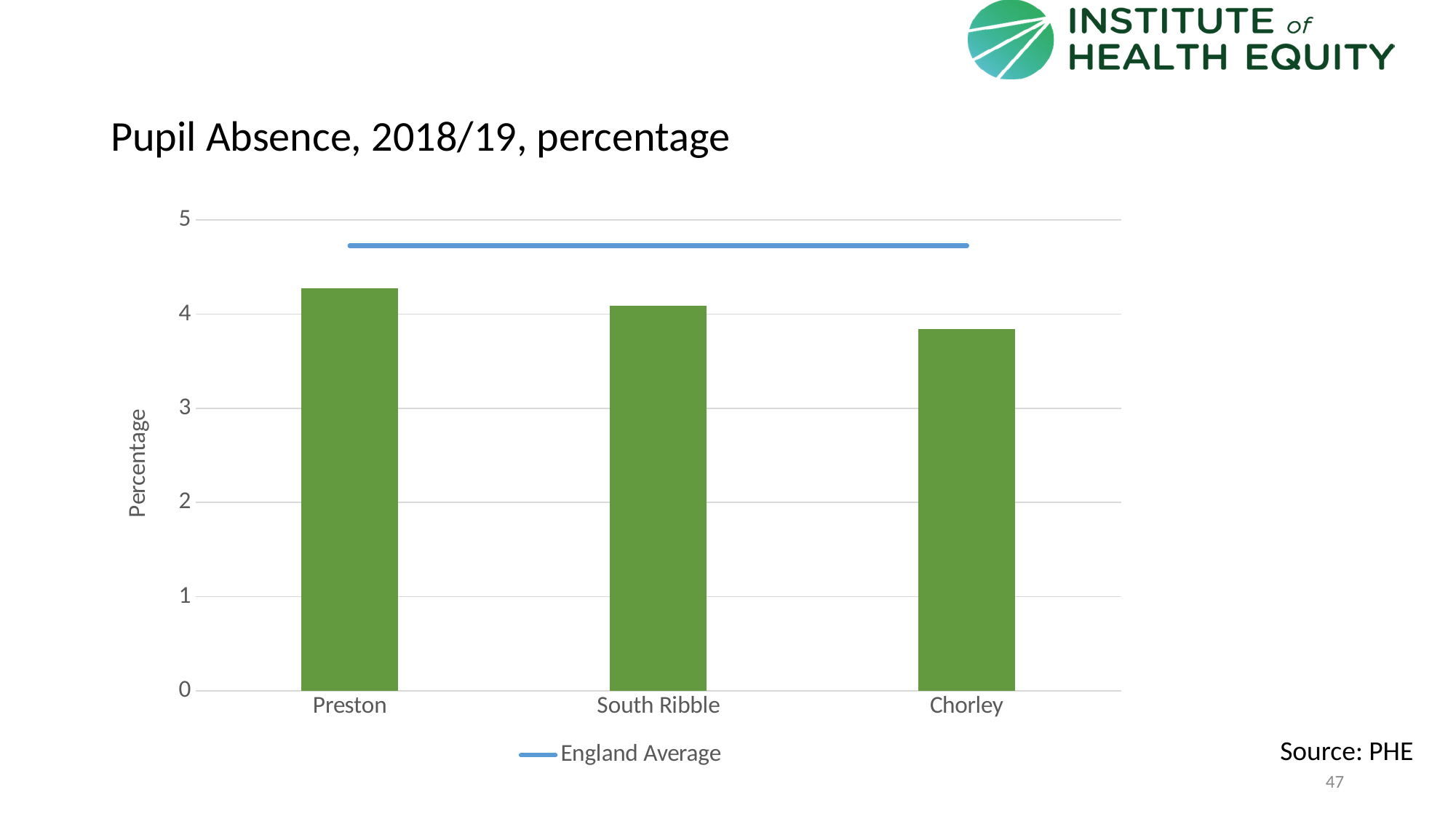
What is the title of the chart? Pupil Absence, 2018/19, percentage Which area has the highest pupil absence percentage? Preston Is the value for Chorley greater or less than 4? less Which area has the lowest pupil absence percentage? Chorley Which has the higher pupil absence percentage, Preston or Chorley? Preston Which has the higher pupil absence percentage, South Ribble or Chorley? South Ribble Do the bar values rise or fall from Preston to Chorley along the x axis? fall What kind of chart is shown on the slide? combination bar and line chart How many areas (categories) are plotted on the x axis? 3 How many entries does the legend list? 1 Is the value for Preston greater or less than 4? greater Is the England Average line greater or less than 5? less